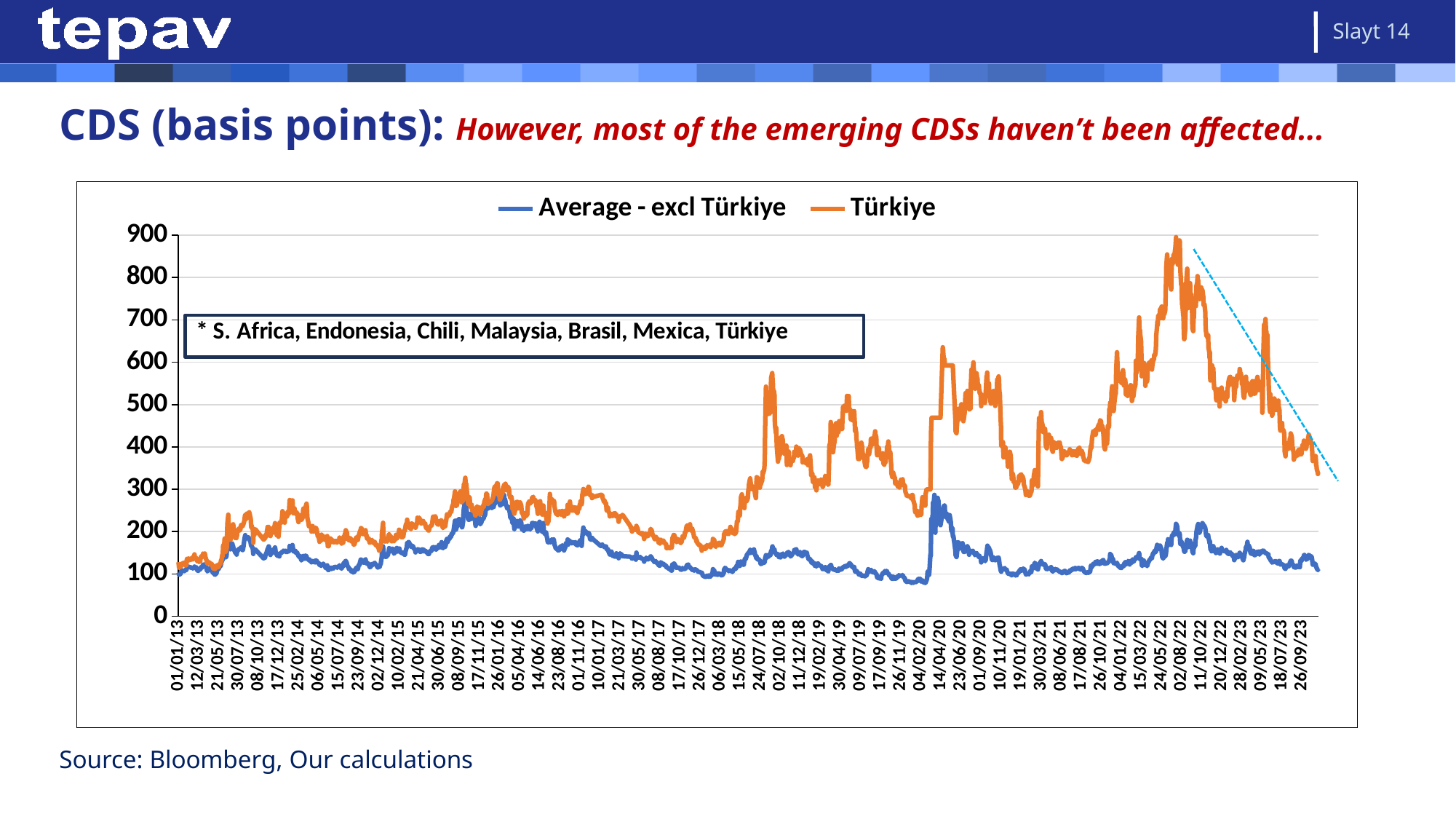
Is the Average - excl Türkiye value at 01/01/13 greater or less than 200? less What is the highest tick value shown on the y axis? 900 Which series reaches the highest value on the chart? Türkiye Is the peak value of the Türkiye series greater or less than 800? greater Around 02/08/22, which series is higher: Türkiye or Average - excl Türkiye? Türkiye Is the Türkiye value at the end of the series (after 26/09/23) greater or less than 500? less What are the two series named in the legend? Average - excl Türkiye and Türkiye How many series does the legend list? 2 What is the title of the chart? CDS (basis points) What type of chart is shown on the slide? line chart Does the Türkiye series rise or fall from its peak around 02/08/22 to the end of the chart? fall